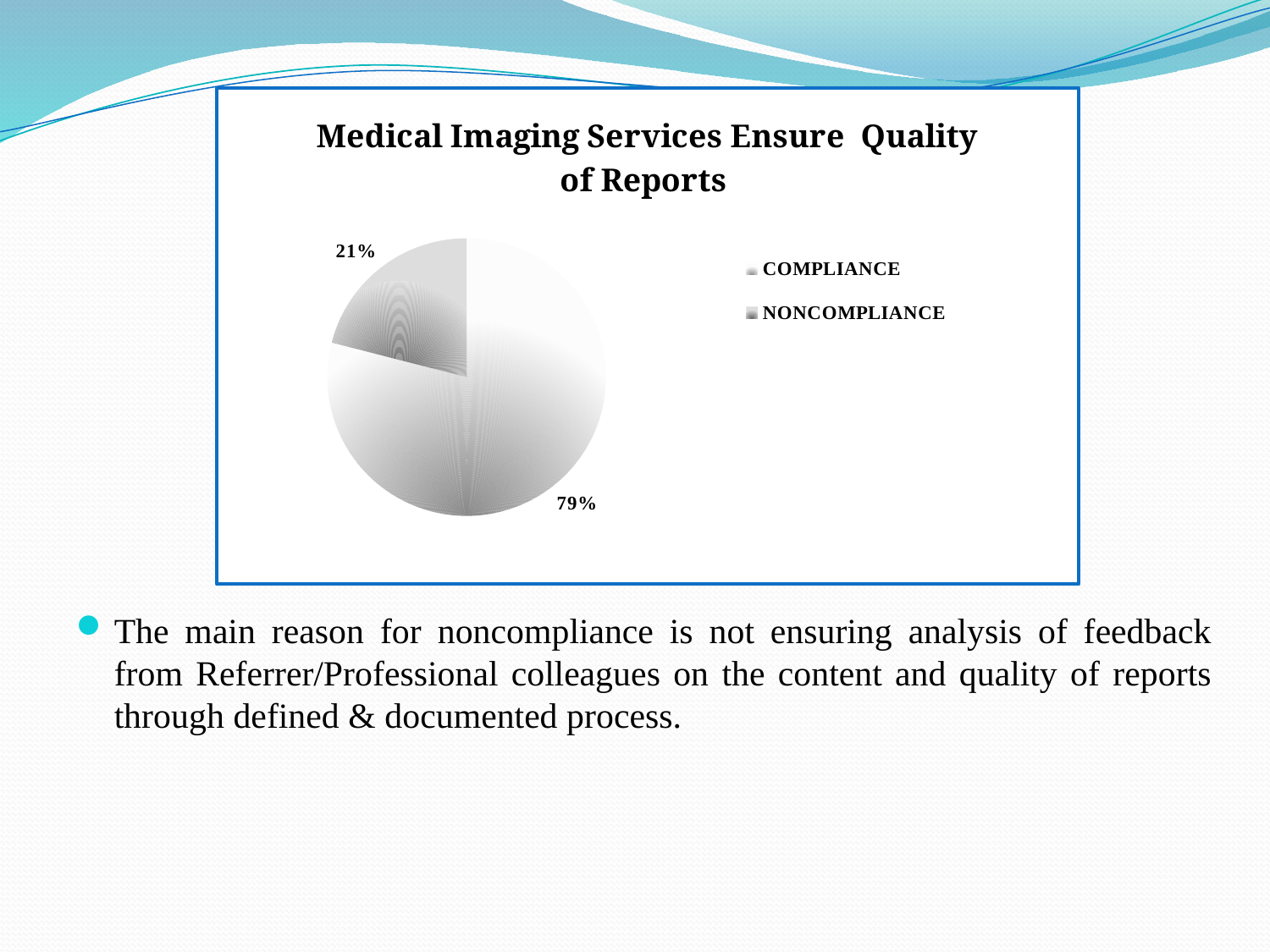
What share of the pie does NONCOMPLIANCE represent? 21% What kind of chart is shown on the slide? Pie chart What is the title of the chart? Medical Imaging Services Ensure Quality of Reports What are the two legend entries of the chart? COMPLIANCE and NONCOMPLIANCE What is the total of the two percentages shown on the pie chart? 100% Which category has the smallest slice of the pie? NONCOMPLIANCE Which category has the largest slice of the pie? COMPLIANCE What is the difference in percentage points between the COMPLIANCE and NONCOMPLIANCE slices? 58 What share of the pie does COMPLIANCE represent? 79% How many entries does the legend list? 2 Which is larger, the COMPLIANCE slice or the NONCOMPLIANCE slice? COMPLIANCE How many slices does the pie chart have? 2